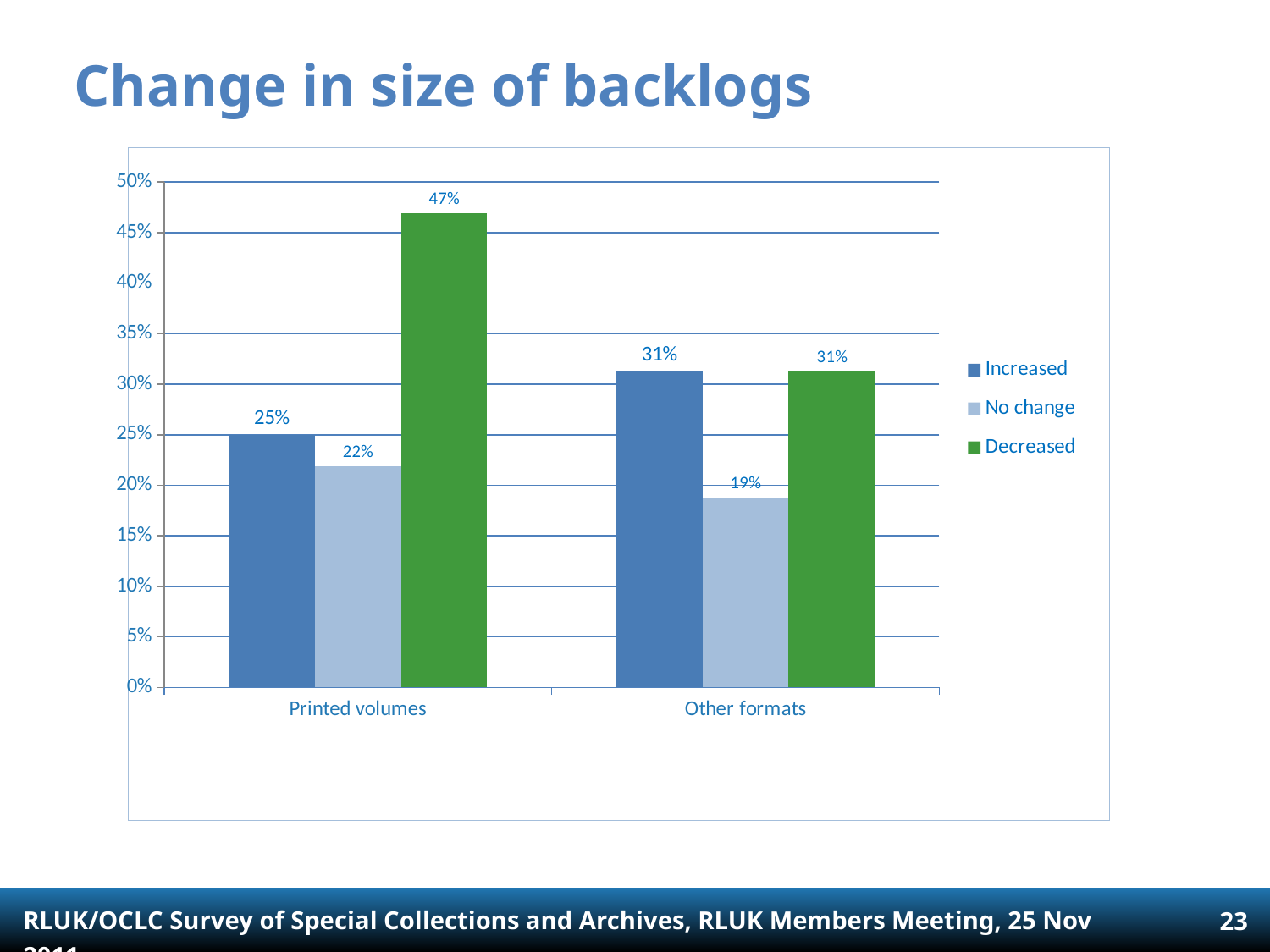
What is the difference between 'Increased' and 'No change' for Other formats? 12% What is the value for 'Increased' in the Printed volumes category? 25% How many categories are shown on the x axis? 2 Which is larger: 'Increased' for Printed volumes or 'Increased' for Other formats? Other formats What is the value for 'No change' in the Other formats category? 19% Which response has the lowest value for Other formats? No change What percentage of respondents reported that backlogs of printed volumes decreased? 47% What is the difference between the 'Decreased' values for Printed volumes and Other formats? 16% Which series is shown in green in the legend? Decreased What kind of chart is shown on the slide? Bar chart Which response has the highest value for Printed volumes? Decreased How many series does the legend list? 3